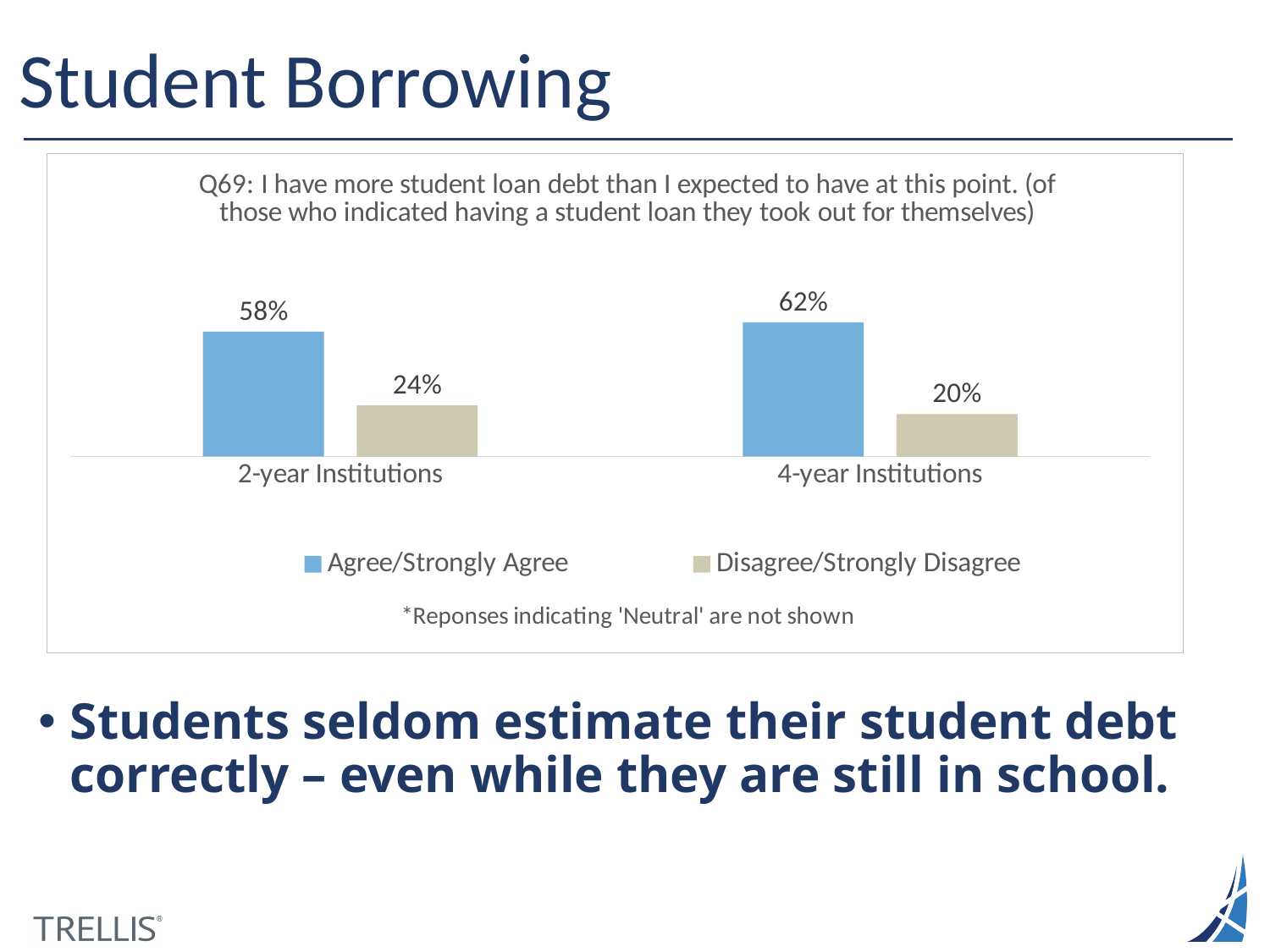
What percentage of respondents at 4-year institutions disagree or strongly disagree that they have more student loan debt than expected? 20% How many series does the legend list? 2 Is the Disagree/Strongly Disagree value larger for 2-year institutions or 4-year institutions? 2-year Institutions What type of chart is shown on the slide? Bar chart How many institution categories are shown on the x axis? 2 Which institution type has the lower Disagree/Strongly Disagree percentage? 4-year Institutions What is the difference between the Agree/Strongly Agree and Disagree/Strongly Disagree percentages at 2-year institutions? 34 percentage points What is the Agree/Strongly Agree value for 4-year institutions? 62% What percentage of respondents at 2-year institutions agree or strongly agree that they have more student loan debt than expected? 58% Which institution type has the higher Agree/Strongly Agree percentage? 4-year Institutions What is the difference between the Agree/Strongly Agree percentages for 4-year and 2-year institutions? 4 percentage points What is the Disagree/Strongly Disagree value for 2-year institutions? 24%